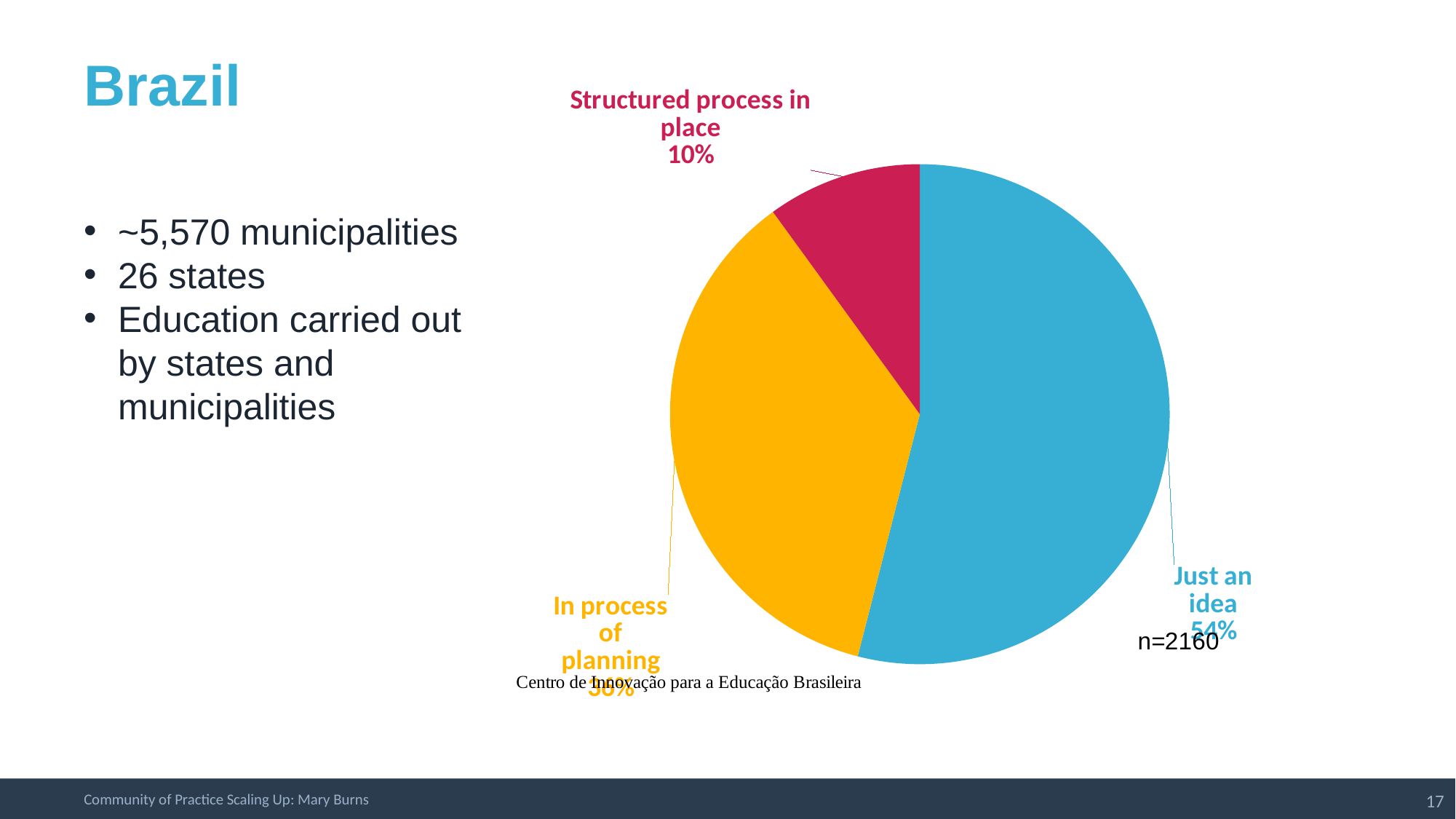
What share of the pie does the "Just an idea" slice represent? 54% What is the difference in percentage points between the "Just an idea" slice and the "Structured process in place" slice? 44 percentage points What sample size (n) is shown next to the pie chart? n=2160 Which category has the largest slice of the pie? Just an idea Which is larger, the "In process of planning" slice or the "Structured process in place" slice? In process of planning What share of the pie does the "Structured process in place" slice represent? 10% What share of the pie does the "In process of planning" slice represent? 36% How many slices does the pie chart have? 3 What kind of chart is shown on the slide? pie chart Which category has the smallest slice of the pie? Structured process in place What is the difference in percentage points between the "Just an idea" slice and the "In process of planning" slice? 18 percentage points What colour is the "Just an idea" slice of the pie chart? blue